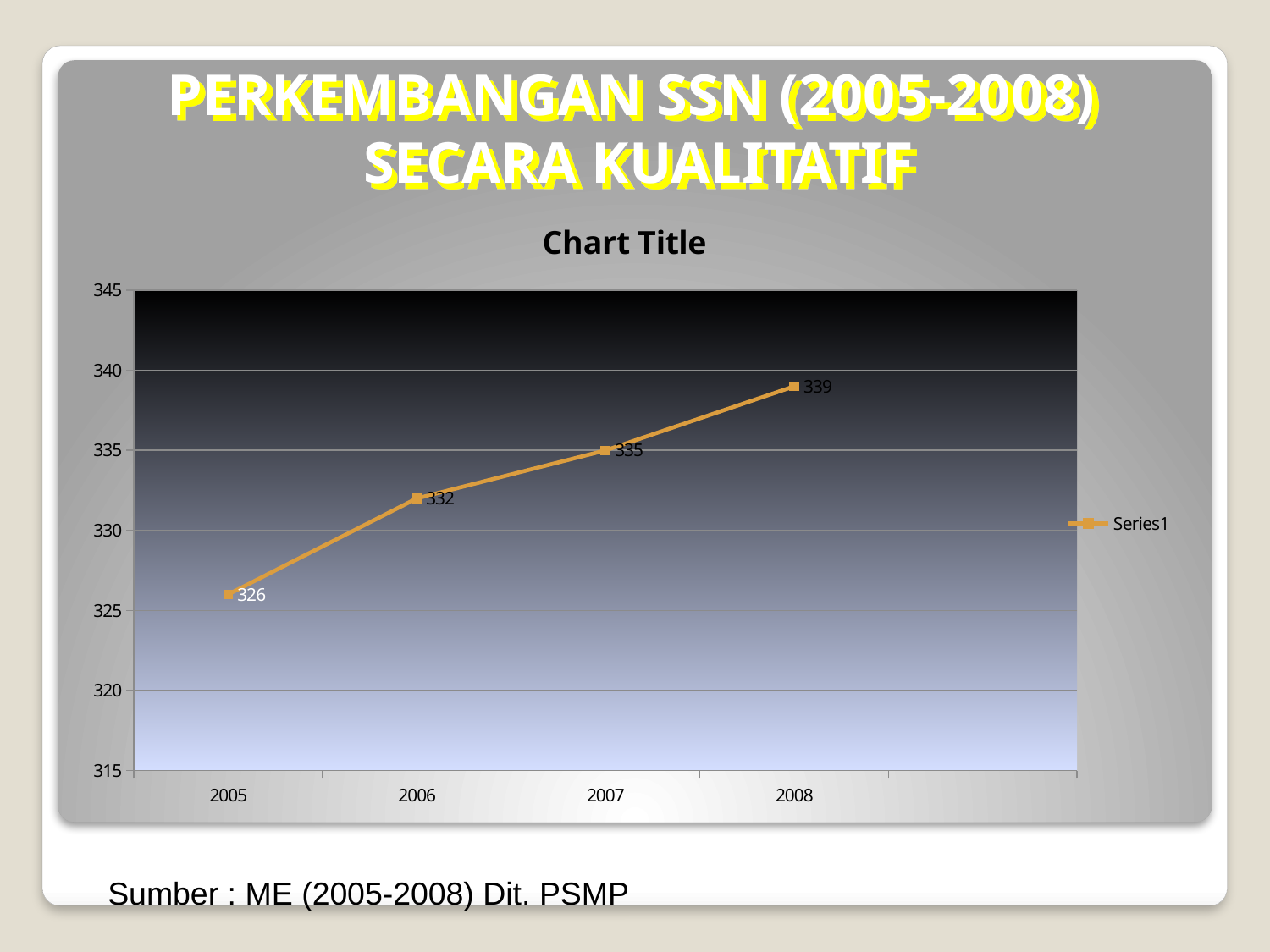
How many years are plotted on the x axis? 4 What kind of chart is shown? line chart What is the value for 2008? 339 What is the value for 2005? 326 What is the value for 2006? 332 Do the values rise or fall from 2005 to 2008? rise Which year has the highest value? 2008 Is the value for 2008 greater or less than 340? less What is the value for 2007? 335 Which year has the lowest value? 2005 What is the difference between the values for 2008 and 2005? 13 Which is larger, the value for 2006 or the value for 2007? 2007